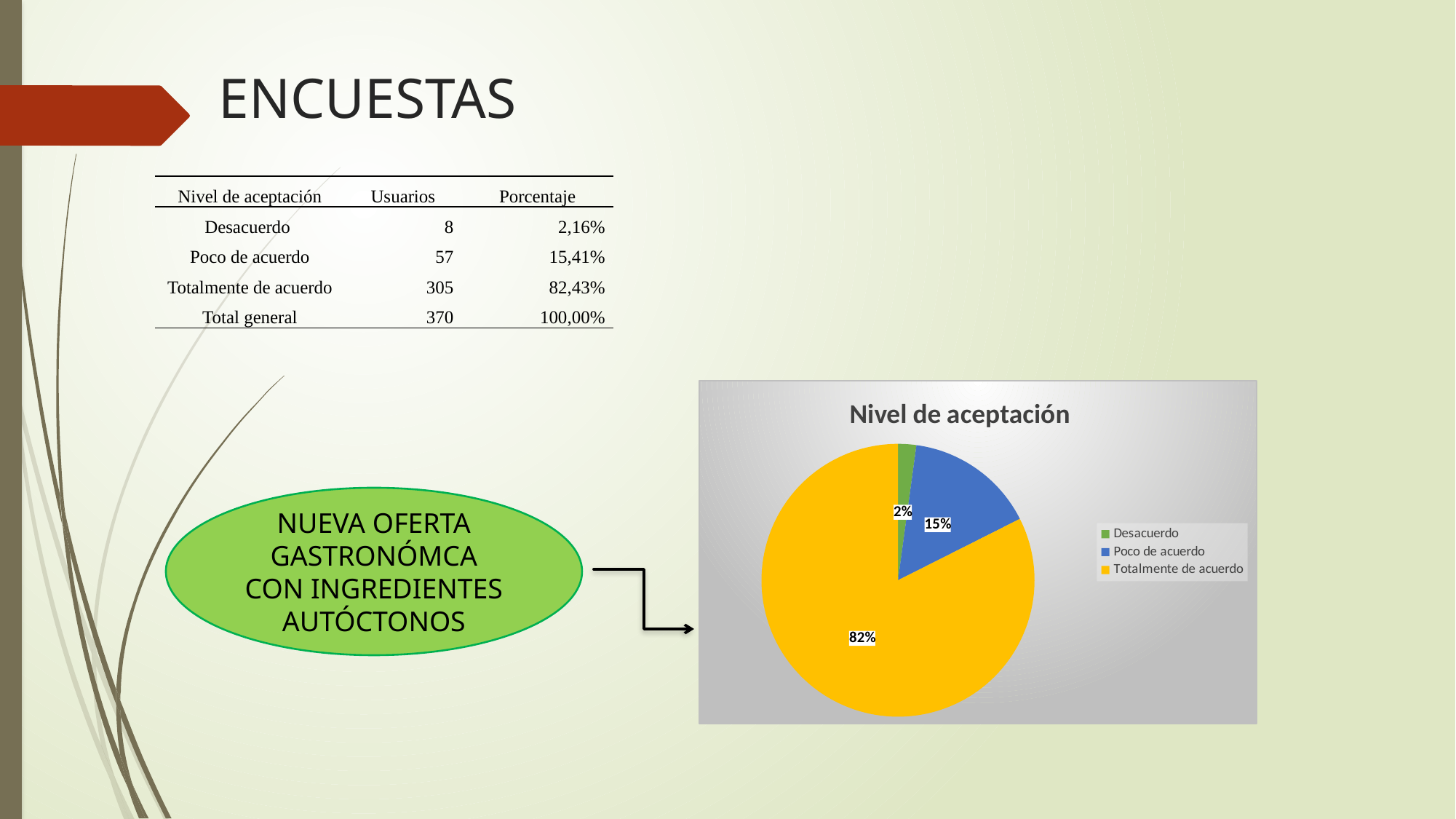
What colour is the Totalmente de acuerdo slice in the pie chart? yellow What percentage does the pie chart show for Poco de acuerdo? 15% How many entries does the chart legend list? 3 Which category has the largest slice in the pie chart? Totalmente de acuerdo Which slice is larger in the pie chart, Poco de acuerdo or Desacuerdo? Poco de acuerdo What percentage does the pie chart show for Desacuerdo? 2% Which category has the smallest slice in the pie chart? Desacuerdo How many slices does the pie chart have? 3 What percentage does the pie chart show for Totalmente de acuerdo? 82% What kind of chart is shown on the slide? pie chart What is the difference in percentage points between the Totalmente de acuerdo slice and the Poco de acuerdo slice? 67% What is the title of the chart? Nivel de aceptación